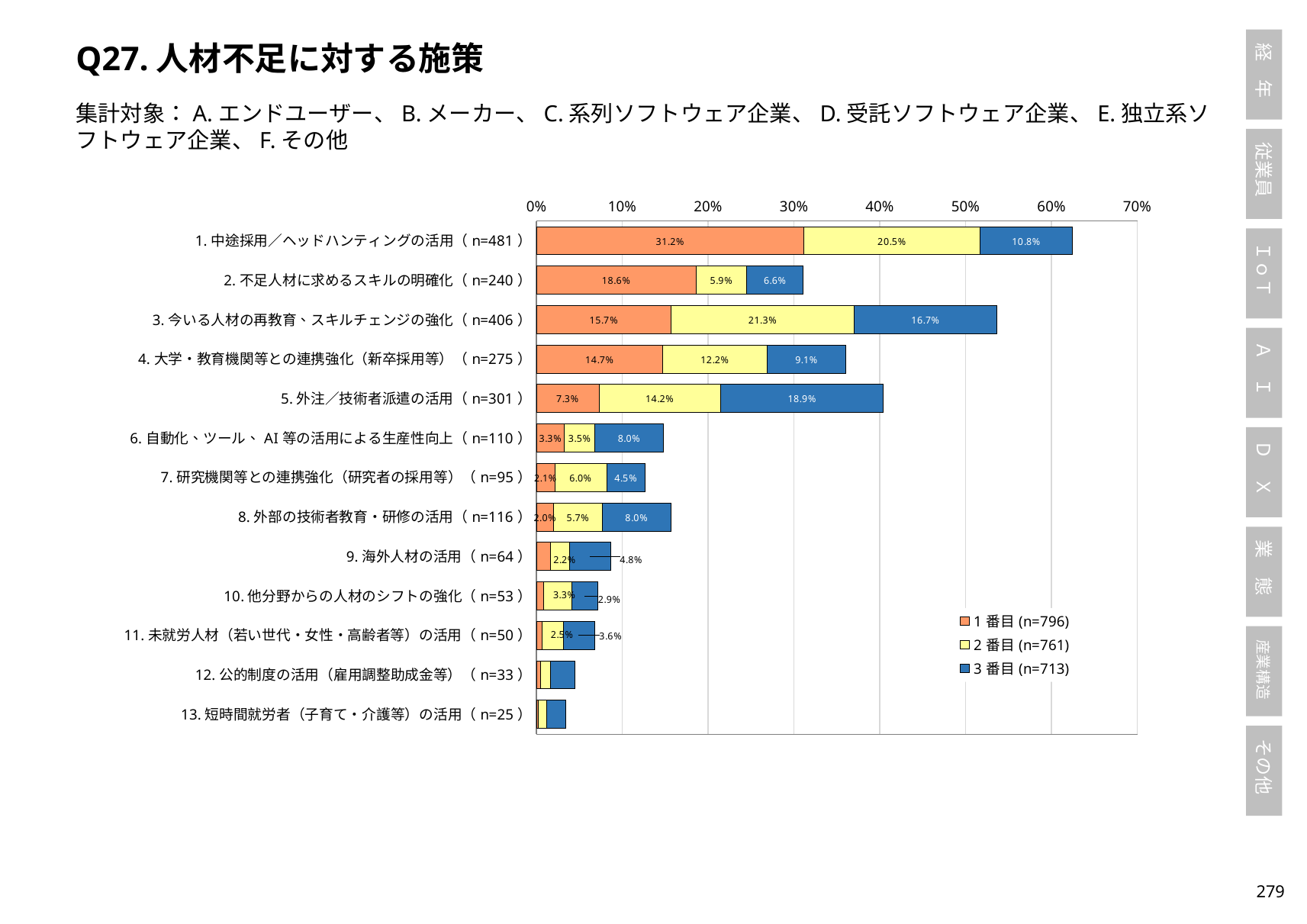
Is the total stacked bar for 12. 公的制度の活用 greater or less than 10%? less Which category has the highest value in the 1番目 series? 1. 中途採用／ヘッドハンティングの活用 Which is larger: the 3番目 value for 3. 今いる人材の再教育、スキルチェンジの強化 or the 3番目 value for 4. 大学・教育機関等との連携強化? 3. 今いる人材の再教育、スキルチェンジの強化 What is the value of the 2番目 series for 3. 今いる人材の再教育、スキルチェンジの強化? 21.3% What kind of chart is shown on the slide? Stacked bar chart What is the total of the stacked bar for 2. 不足人材に求めるスキルの明確化? 31.1% Is the total stacked bar for 1. 中途採用／ヘッドハンティングの活用 greater or less than 60%? greater What is the value of the 1番目 series for 1. 中途採用／ヘッドハンティングの活用? 31.2% What is the value of the 3番目 series for 5. 外注／技術者派遣の活用? 18.9% How many series does the legend list? 3 What is the difference between the 1番目 values for 1. 中途採用／ヘッドハンティングの活用 and 2. 不足人材に求めるスキルの明確化? 12.6% How many categories are shown on the chart? 13